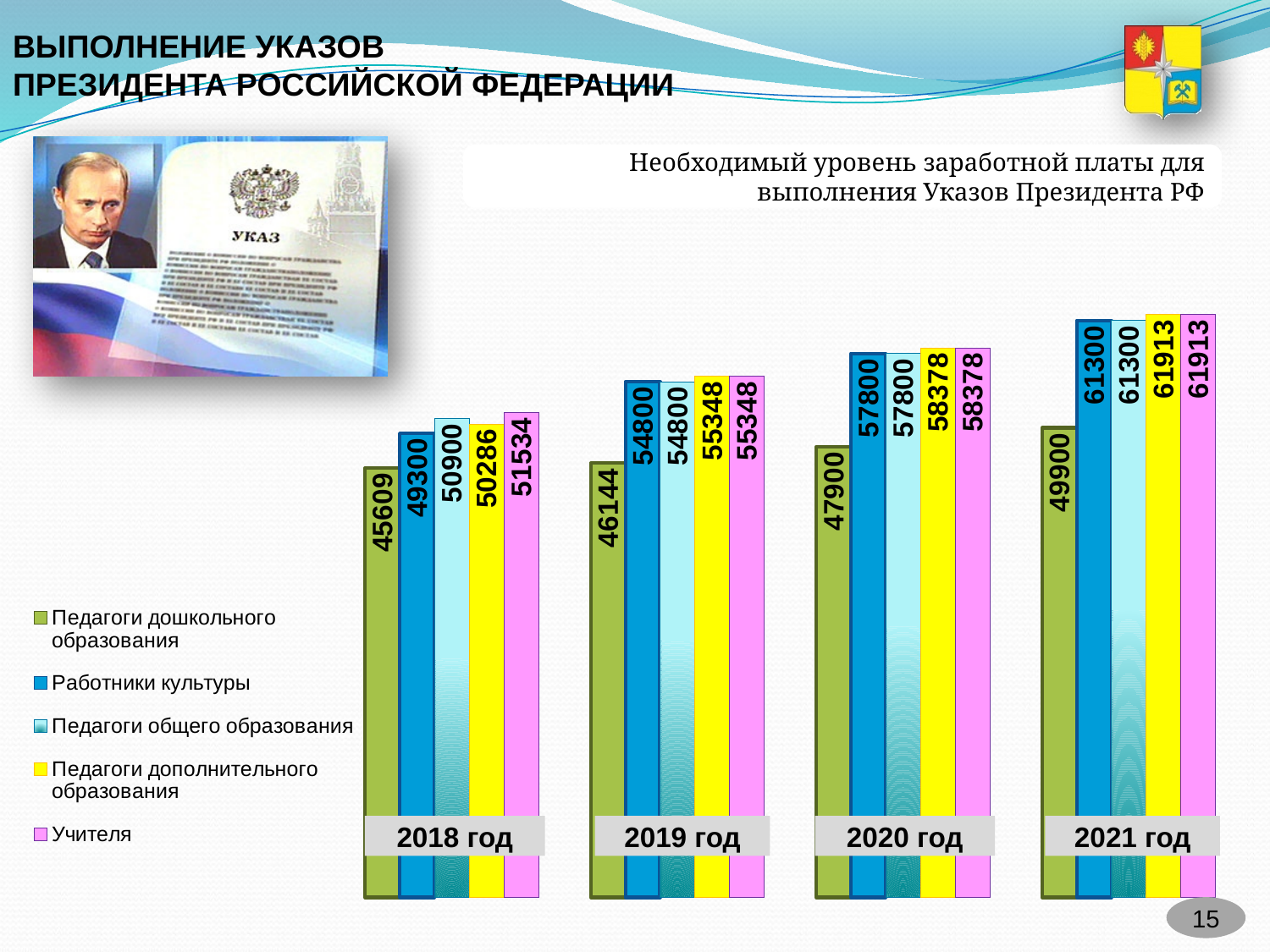
What is the value for Педагоги дошкольного образования in 2020 год? 47900 What is the value for Педагоги дополнительного образования in 2019 год? 55348 What is the value for Учителя in 2018 год? 51534 How many year categories are shown on the x axis? 4 Which is larger in 2018 год: the value for Педагоги общего образования or the value for Педагоги дополнительного образования? Педагоги общего образования How many series does the legend list? 5 Which series has the lowest value in 2018 год? Педагоги дошкольного образования What is the difference between the values for Учителя and Педагоги дошкольного образования in 2021 год? 12013 What is the difference between the value for Работники культуры in 2019 год and in 2018 год? 5500 What is the value for Работники культуры in 2021 год? 61300 What kind of chart is shown on the slide? Bar chart Which year has the highest value for Учителя? 2021 год